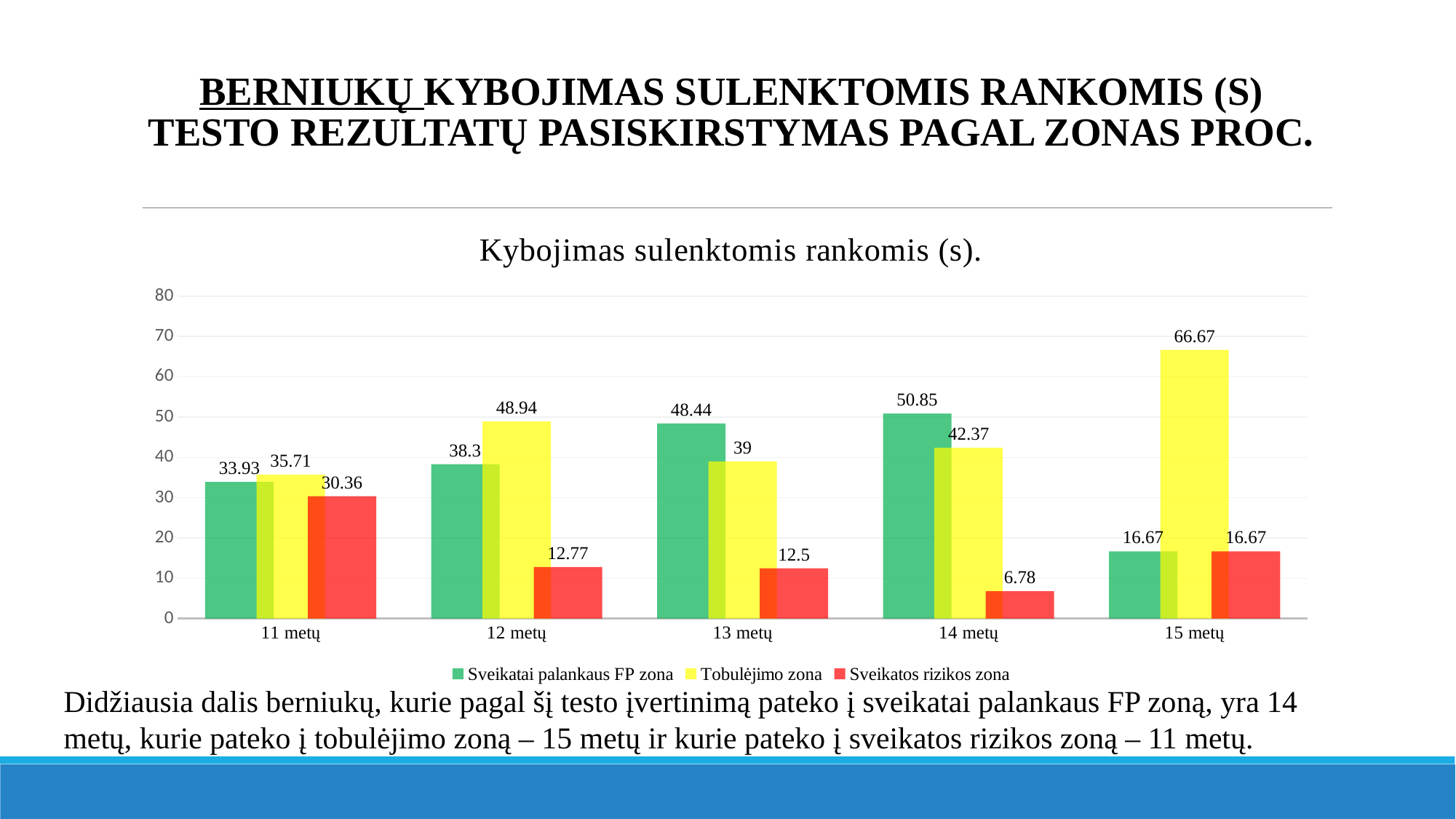
What is the value for Tobulėjimo zona at 15 metų? 66.67 Which age group has the highest value for Sveikatos rizikos zona? 11 metų How many series does the legend list? 3 Which age group has the lowest value for Sveikatai palankaus FP zona? 15 metų What is the value for Sveikatos rizikos zona at 11 metų? 30.36 What is the title of the chart? Kybojimas sulenktomis rankomis (s). Which age group has the lowest value for Sveikatos rizikos zona? 14 metų What type of chart is shown on the slide? Bar chart What is the value for Sveikatai palankaus FP zona at 14 metų? 50.85 How many age groups are shown on the x axis? 5 What is the difference between the Tobulėjimo zona and Sveikatai palankaus FP zona values at 15 metų? 50 At 13 metų, which is larger: Sveikatai palankaus FP zona or Tobulėjimo zona? Sveikatai palankaus FP zona